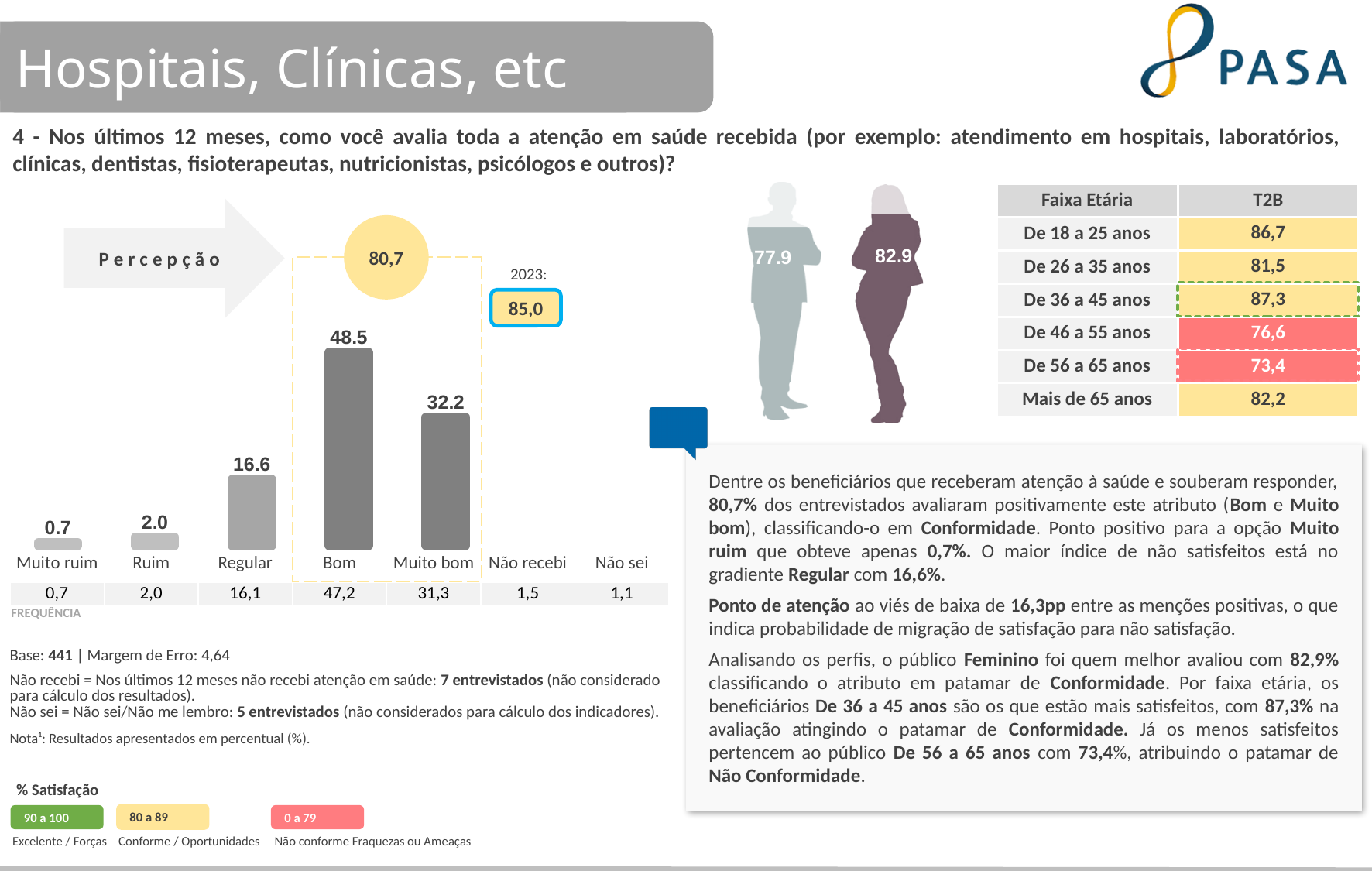
What is the combined value of the Bom and Muito bom bars, as shown in the yellow circle above the chart? 80,7 What is the value shown for the Regular bar in the chart? 16.6 What value is shown in the FREQUÊNCIA row for the Bom category? 47,2 What type of chart is used to show the evaluation results? Bar chart What is the difference between the Bom and Muito bom bar values? 16.3 What is the value shown for the Muito bom bar in the chart? 32.2 Which is larger, the Regular bar or the Ruim bar? Regular What is the value shown for the Bom bar in the chart? 48.5 What value is shown in the 2023 box next to the chart? 85,0 Which category has the lowest bar in the chart? Muito ruim Which category has the highest bar in the chart? Bom What is the value shown for the Muito ruim bar in the chart? 0.7